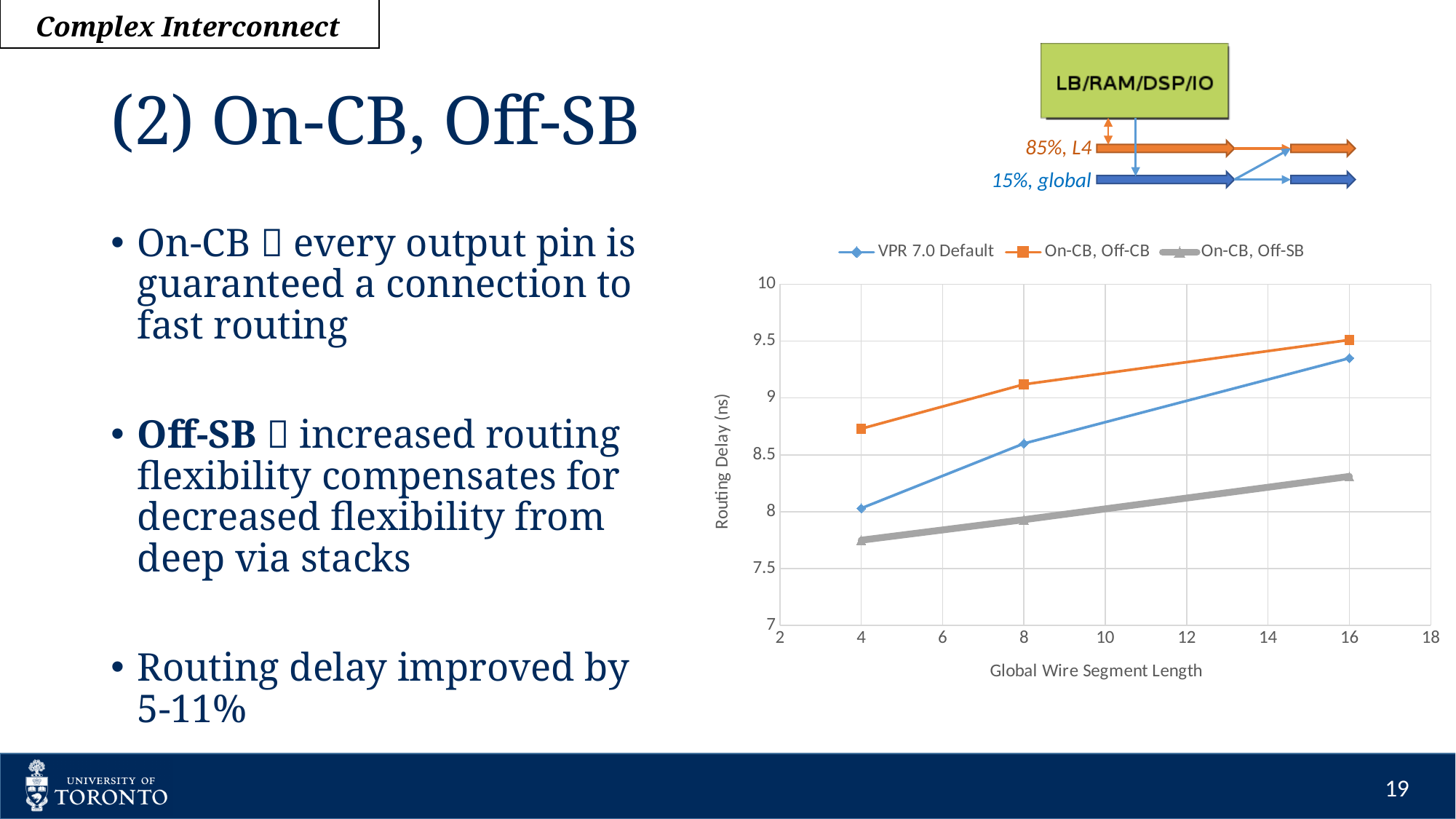
Is the routing delay for On-CB, Off-SB at a global wire segment length of 4 greater or less than 8? less Which series has the highest routing delay at a global wire segment length of 16? On-CB, Off-CB Is the routing delay for On-CB, Off-CB at a global wire segment length of 4 greater or less than 8.5? greater How many data points are plotted for the VPR 7.0 Default series? 3 Is the routing delay for VPR 7.0 Default at a global wire segment length of 16 greater or less than 9? greater How many series does the chart legend list? 3 What kind of chart is shown on the slide? line chart At a global wire segment length of 8, which series has the higher routing delay: VPR 7.0 Default or On-CB, Off-SB? VPR 7.0 Default Which series has the lowest routing delay at a global wire segment length of 4? On-CB, Off-SB What is the label of the chart's y axis? Routing Delay (ns) Does the routing delay for the On-CB, Off-SB series rise or fall as the global wire segment length increases? rise